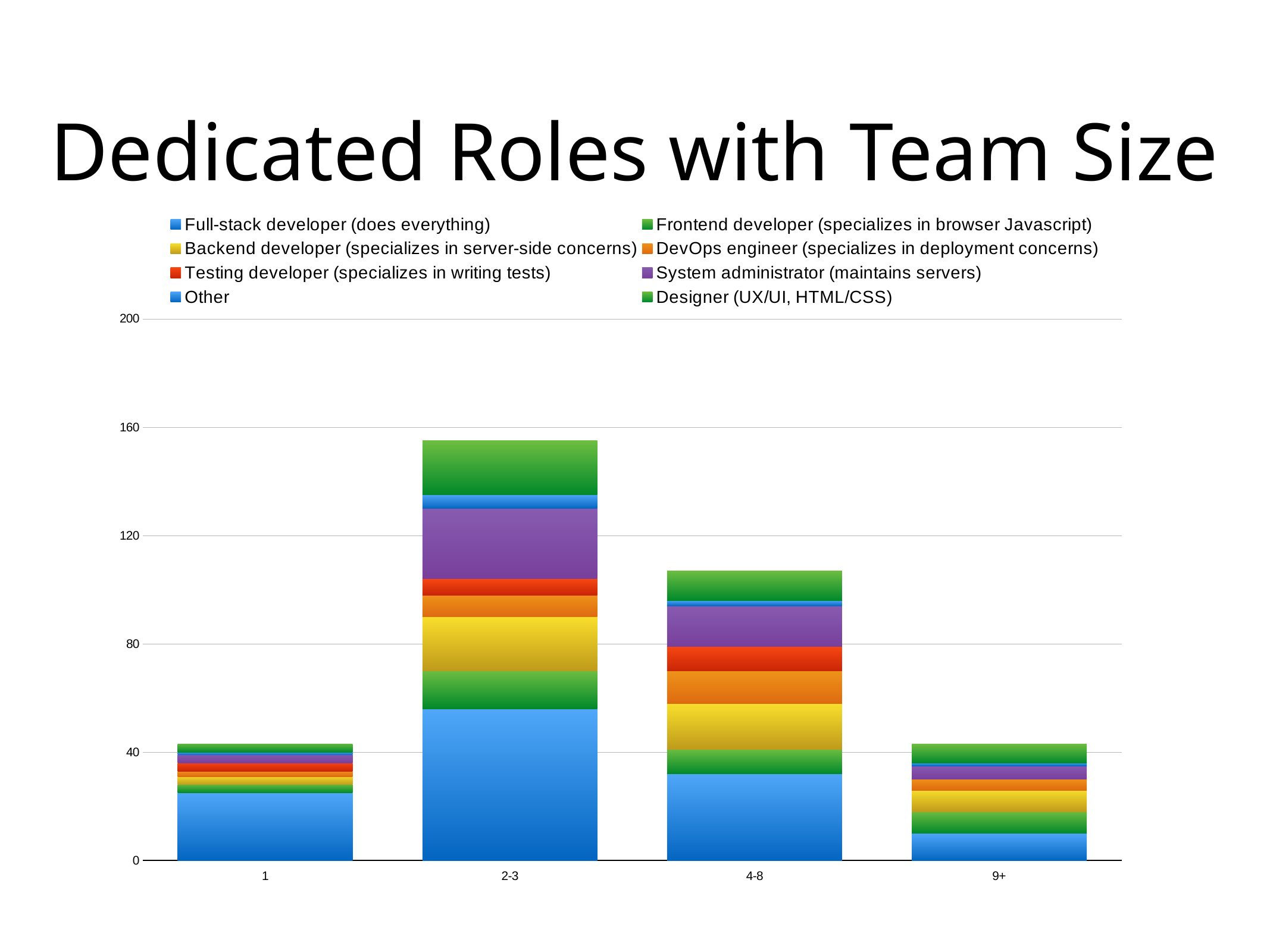
What is the title of the chart on the slide? Dedicated Roles with Team Size What kind of chart is shown on the slide? stacked bar chart Is the total stacked value for team size 4-8 greater or less than 80? greater Is the total stacked value for team size 4-8 greater or less than 120? less Is the total stacked value for team size 2-3 greater or less than 120? greater Which is larger: the total stacked bar for team size 2-3 or for team size 4-8? 2-3 Which team-size category has the tallest stacked bar? 2-3 How many series does the legend list? 8 How many team-size categories are shown on the x axis? 4